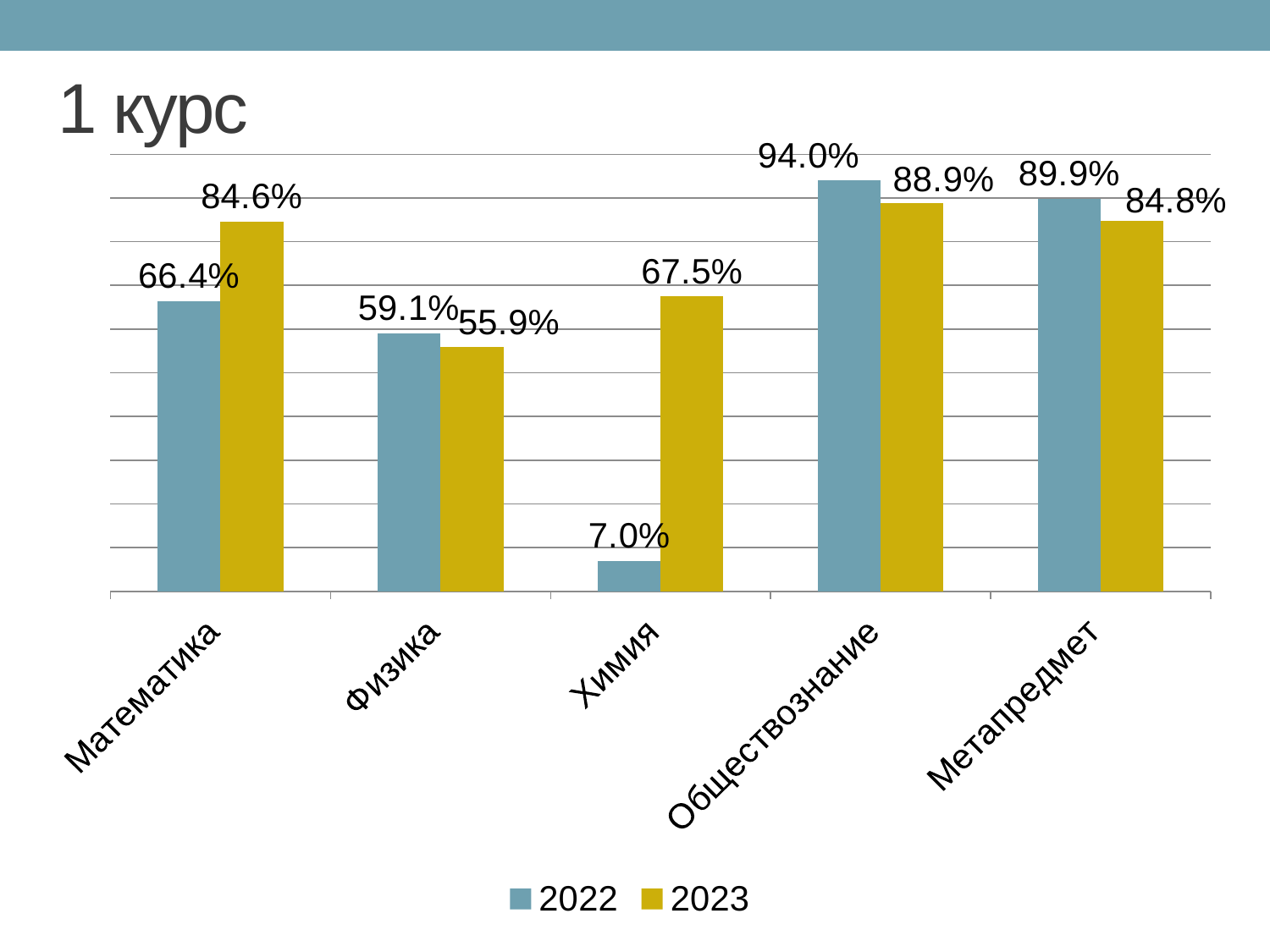
What is the 2022 value for Обществознание? 94.0% What is the 2023 value for Математика? 84.6% How many categories are shown on the x axis? 5 What kind of chart is shown on the slide? Bar chart Which category has the highest 2022 value? Обществознание What are the two series listed in the legend? 2022 and 2023 Which is larger for Физика, the 2022 value or the 2023 value? 2022 What is the 2022 value for Химия? 7.0% What is the 2023 value for Метапредмет? 84.8% How many series does the legend list? 2 What is the difference between the 2023 and 2022 values for Математика? 18.2% Which category has the lowest 2023 value? Физика